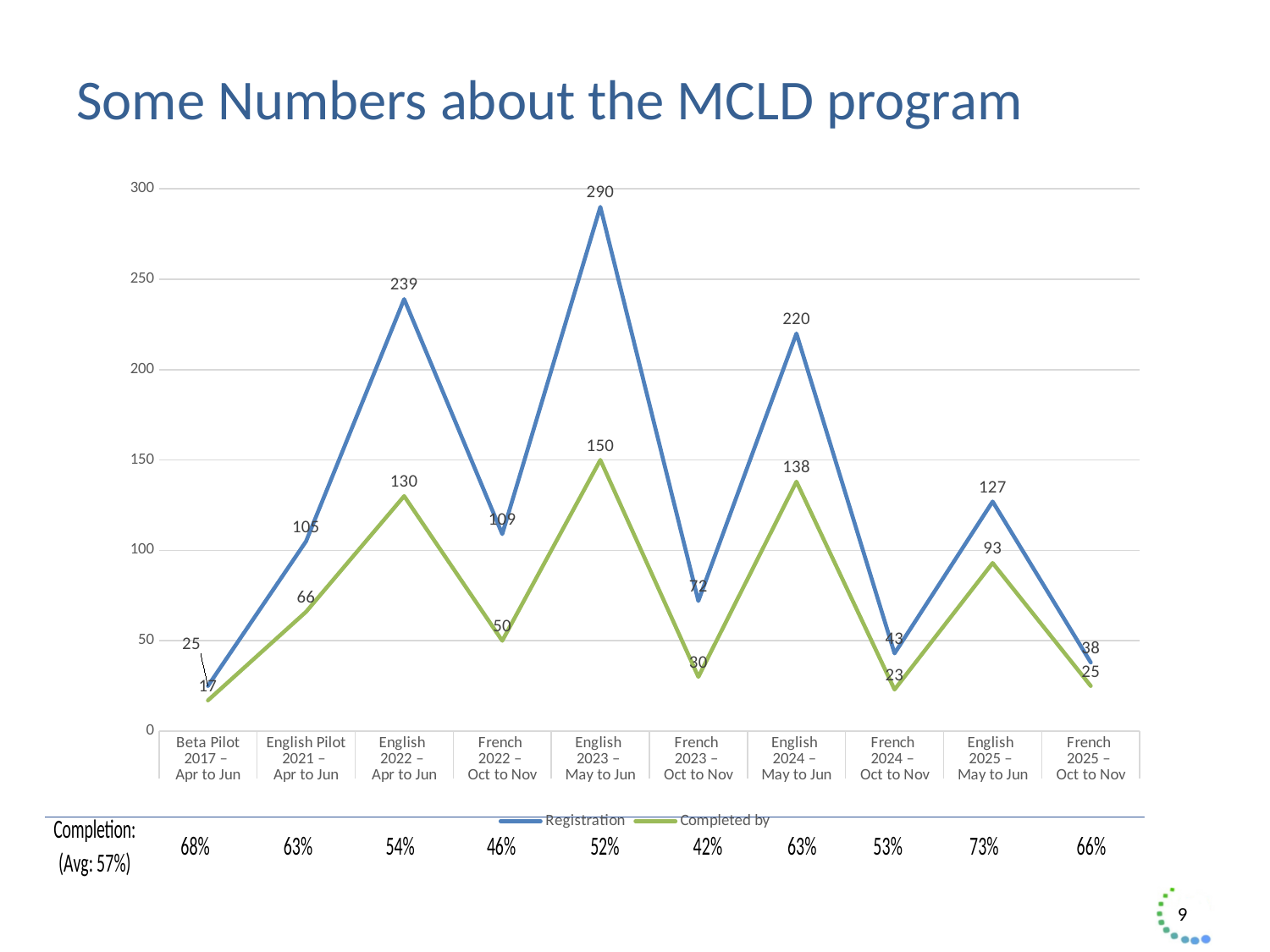
How many categories are plotted along the x axis of the chart? 10 What is the Completed by value for English 2024 – May to Jun? 138 What is the completion percentage shown below the chart for English 2025 – May to Jun? 73% What kind of chart is shown on the slide? line chart Is the Registration value for English 2024 – May to Jun greater or less than 200? greater What is the difference between Registration and Completed by for English 2022 – Apr to Jun? 109 Which category has the highest Registration value? English 2023 – May to Jun What is the Registration value for English 2023 – May to Jun? 290 What is the title of the slide containing the chart? Some Numbers about the MCLD program Which is larger: the Registration value for French 2022 – Oct to Nov or the Registration value for English 2025 – May to Jun? English 2025 – May to Jun Which category has the lowest Completed by value? Beta Pilot 2017 – Apr to Jun How many series does the chart legend list? 2